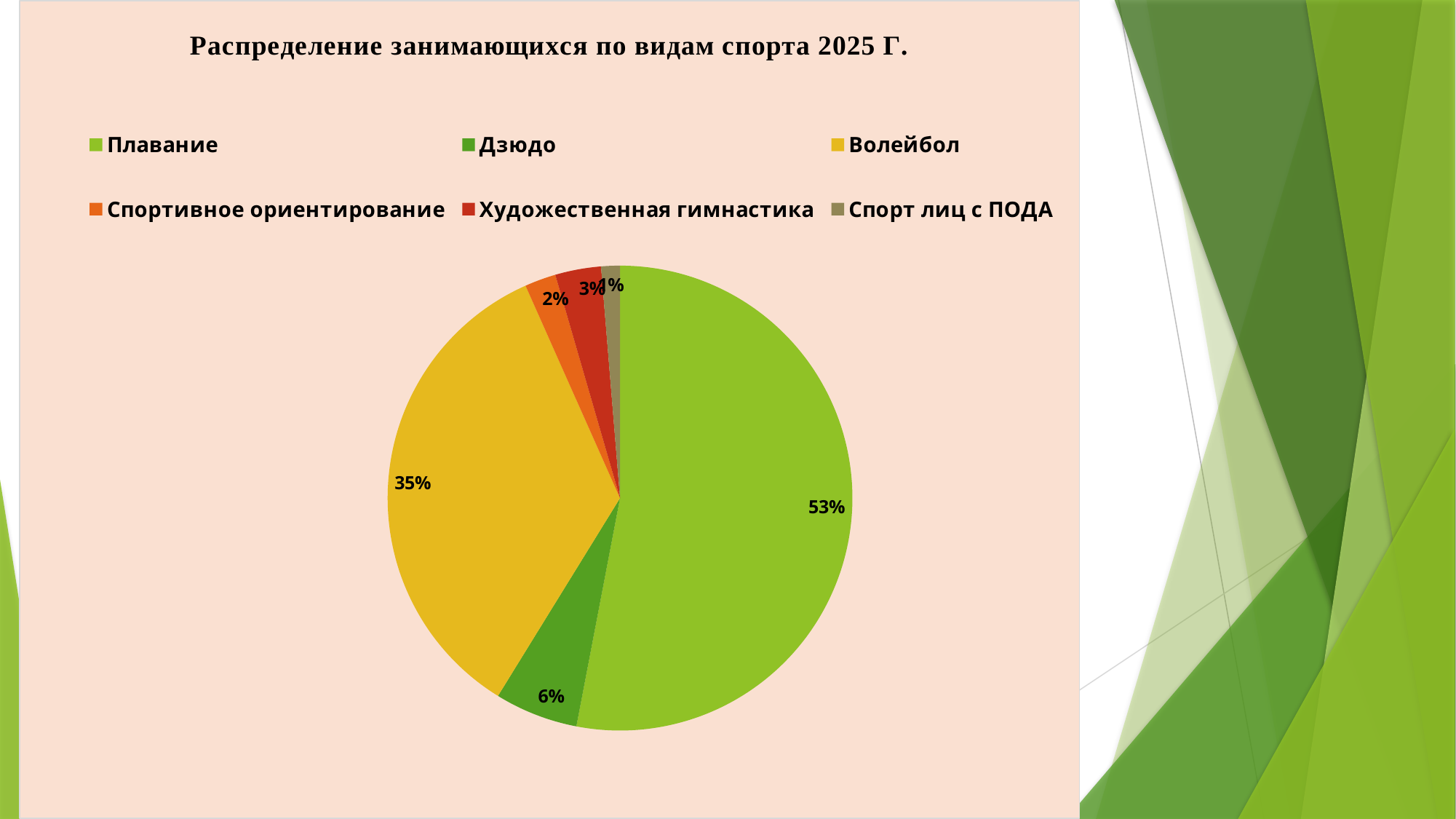
What kind of chart is shown on the slide? Pie chart What is the value for Дзюдо? 6% Which category has the largest share of the pie? Плавание What is the value for Спортивное ориентирование? 2% Which category has the smallest share of the pie? Спорт лиц с ПОДА How many categories does the pie chart show? 6 Which is larger, the share for Дзюдо or the share for Художественная гимнастика? Дзюдо What is the value for Художественная гимнастика? 3% What is the difference between the shares of Плавание and Волейбол? 18% What is the title of the chart? Распределение занимающихся по видам спорта 2025 Г. What share of the pie does Плавание have? 53% What share of the pie does Волейбол have? 35%